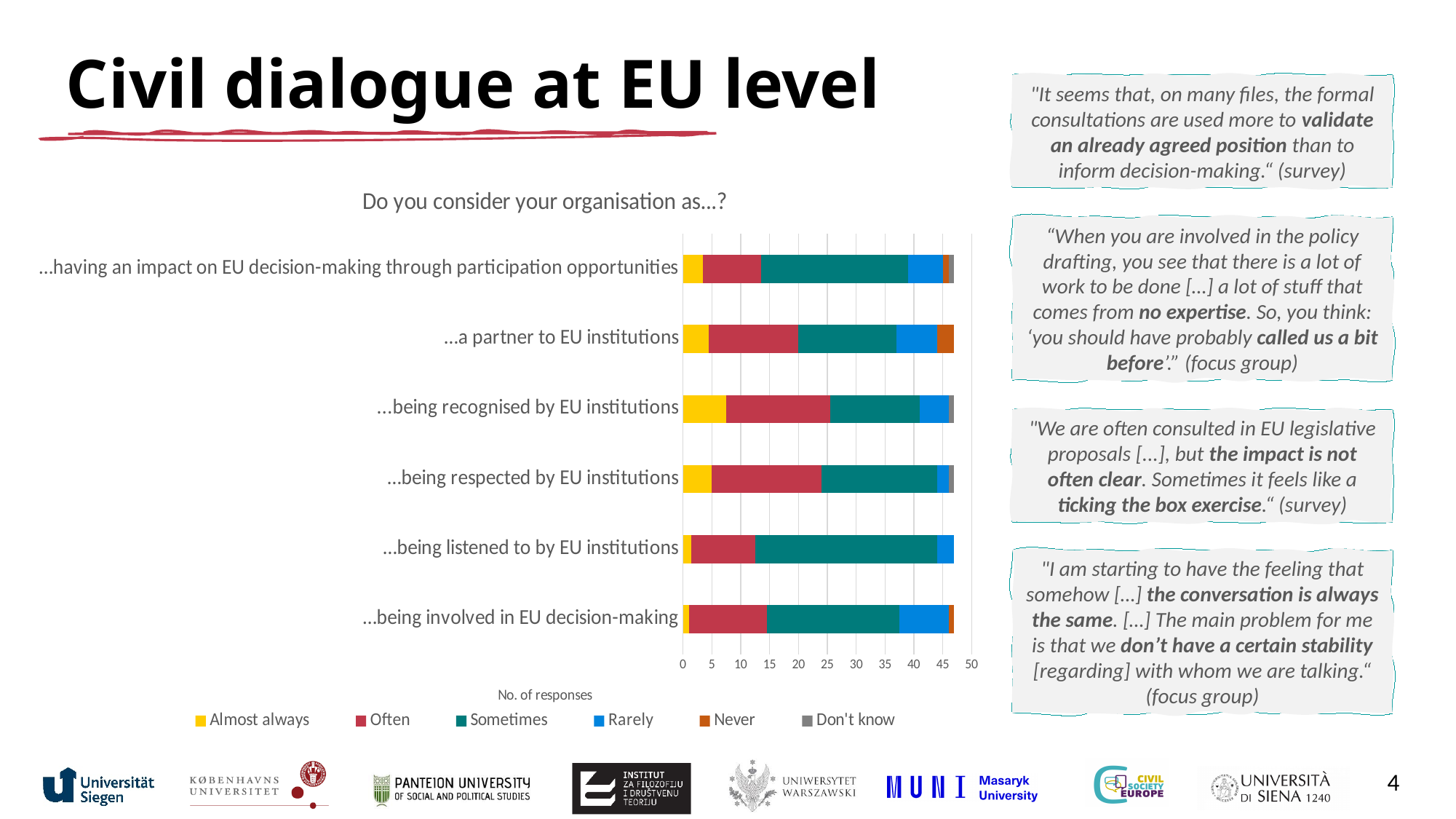
Which category has the largest 'Almost always' segment? ...being recognised by EU institutions What kind of chart is shown on the slide? Bar chart How many series does the chart legend list? 6 Is the total number of responses for '...being listened to by EU institutions' greater or less than 40? greater Is the 'Almost always' value for '...being recognised by EU institutions' greater or less than 5? greater Is the 'Sometimes' segment larger for '...being listened to by EU institutions' or for '...a partner to EU institutions'? ...being listened to by EU institutions Which category has the largest 'Sometimes' segment? ...being listened to by EU institutions Is the total number of responses for '...being involved in EU decision-making' greater or less than 50? less What is the label of the horizontal axis of the chart? No. of responses What is the title of the chart? Do you consider your organisation as...? How many categories (statements) are plotted in the chart? 6